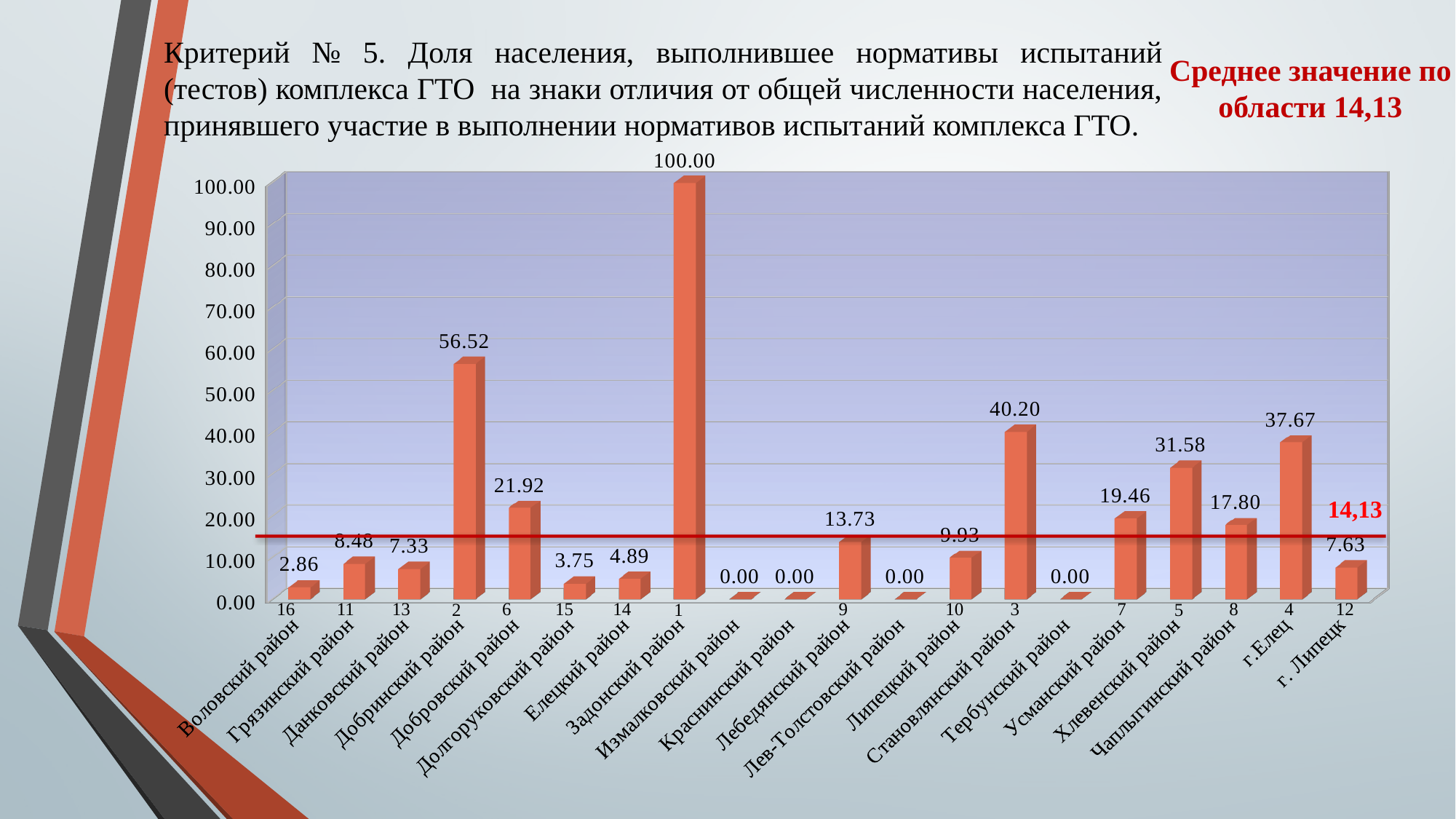
What kind of chart is shown on the slide? bar chart What is the difference between the values for Становлянский район and г.Елец? 2.53 What is the value for Добринский район? 56.52 How many categories have a value of 0.00? 4 What is the value for г. Липецк? 7.63 What is the difference between the values for Добровский район and Лебедянский район? 8.19 How many categories are shown on the x axis? 20 Which is larger, the value for Усманский район or the value for Чаплыгинский район? Усманский район What value does the red horizontal line mark? 14,13 Which category has the highest value? Задонский район What is the value for Задонский район? 100.00 What is the value for Хлевенский район? 31.58